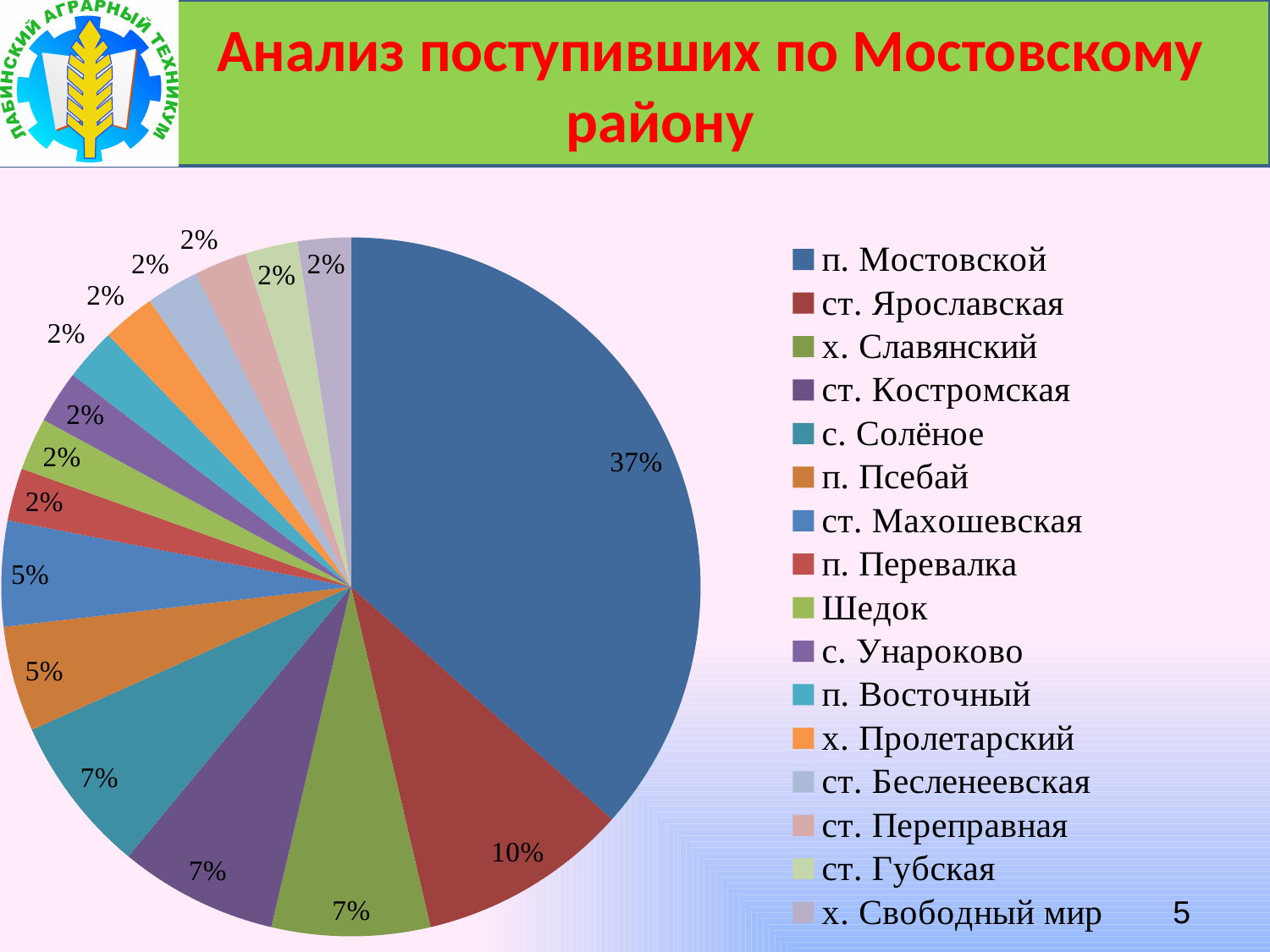
What is the title of the slide containing the chart? Анализ поступивших по Мостовскому району What is the value shown for х. Славянский? 7% Which is larger, the share of ст. Костромская or the share of ст. Махошевская? ст. Костромская How many categories does the pie chart contain? 16 Which legend entry is listed first in the chart legend? п. Мостовской What is the value shown for п. Псебай? 5% What is the value shown for ст. Ярославская? 10% What kind of chart is shown on the slide? pie chart Which category has the largest share of the pie? п. Мостовской What is the value shown for ст. Губская? 2% What share of the pie does п. Мостовской have? 37% What is the difference between the shares of п. Мостовской and ст. Ярославская? 27%